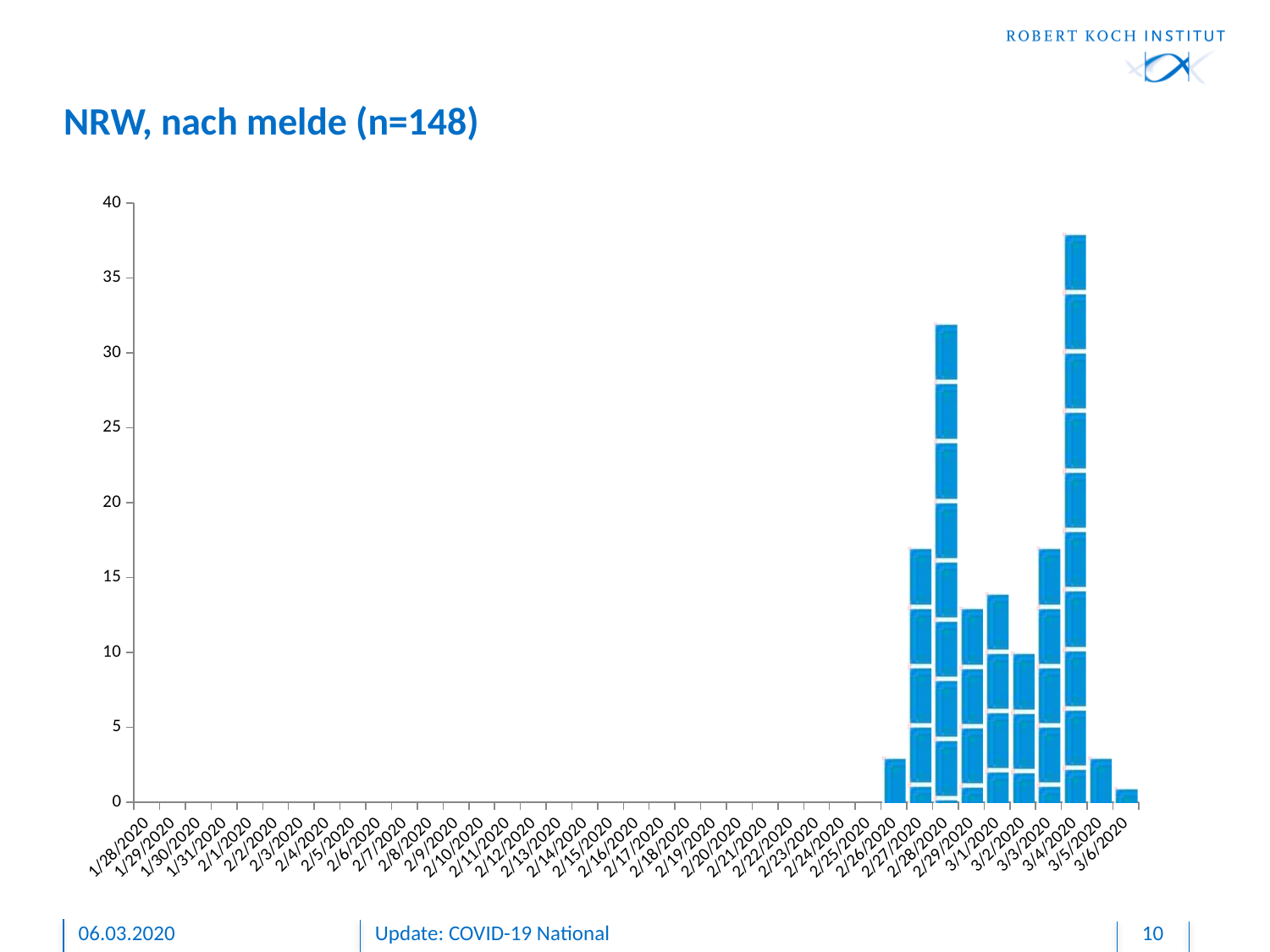
Is the value for 3/2/2020 greater or less than 15? less Do the values rise or fall from 2/26/2020 to 2/28/2020? rise Which is larger, the value for 2/28/2020 or the value for 3/4/2020? 3/4/2020 Is the value for 2/27/2020 greater or less than 15? greater What kind of chart is shown on the slide? bar chart Which date has the highest bar? 3/4/2020 Is the value for 2/26/2020 greater or less than 5? less What is the title of the chart? NRW, nach melde (n=148) Which is larger, the value for 2/29/2020 or the value for 3/2/2020? 2/29/2020